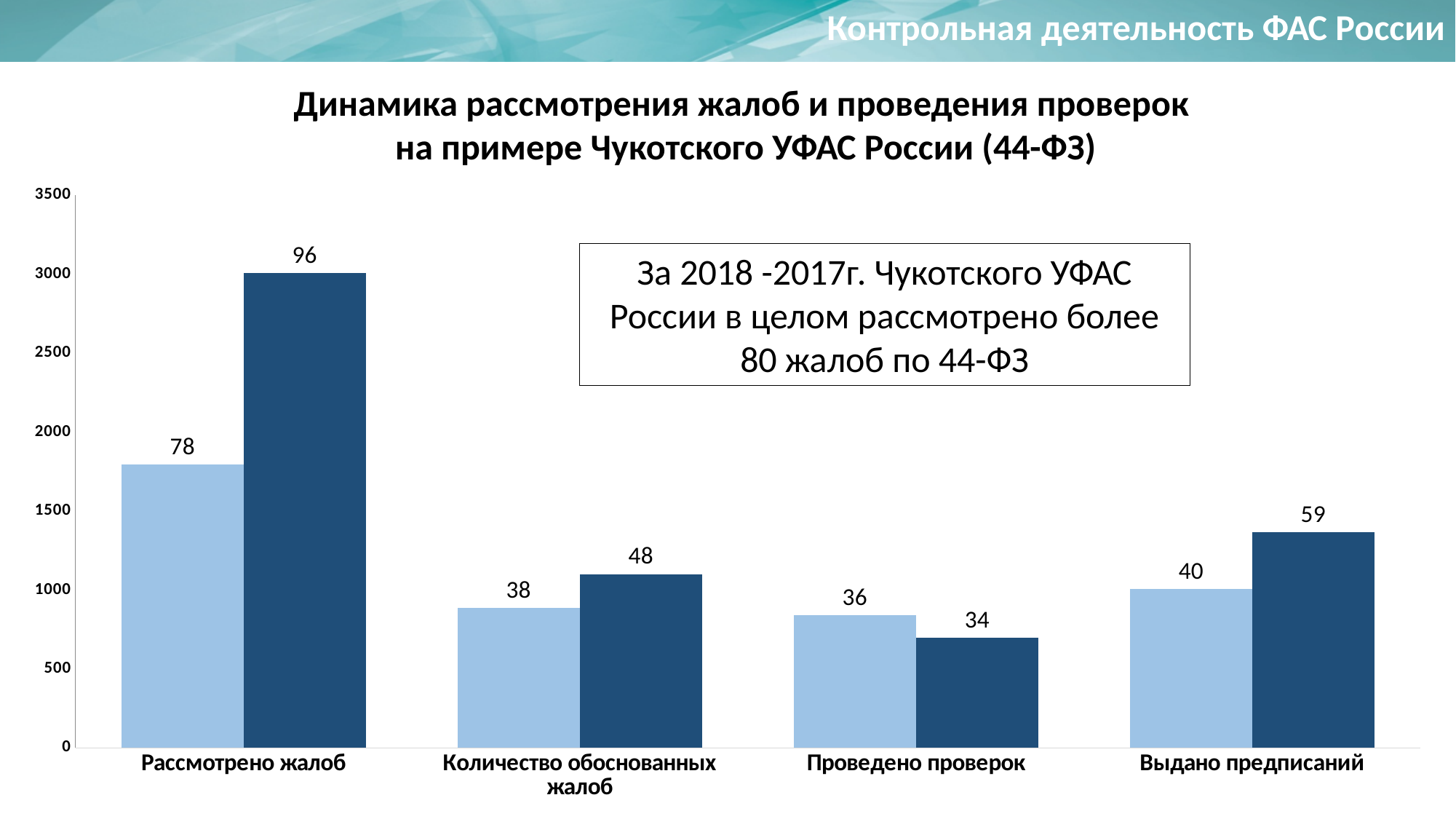
What is the difference between the dark blue and light blue bars for "Выдано предписаний"? 19 How many categories are shown on the x axis? 4 What is the difference between the dark blue and light blue bars for "Рассмотрено жалоб"? 18 What is the title of the chart? Динамика рассмотрения жалоб и проведения проверок на примере Чукотского УФАС России (44-ФЗ) What is the value of the dark blue bar for "Выдано предписаний"? 59 Which category has the lowest light blue bar? Проведено проверок What kind of chart is shown on the slide? bar chart What is the value of the dark blue bar for "Рассмотрено жалоб"? 96 What is the value of the light blue bar for "Рассмотрено жалоб"? 78 Which category has the highest dark blue bar? Рассмотрено жалоб For "Проведено проверок", which bar is larger, the light blue or the dark blue? light blue What is the value of the light blue bar for "Проведено проверок"? 36